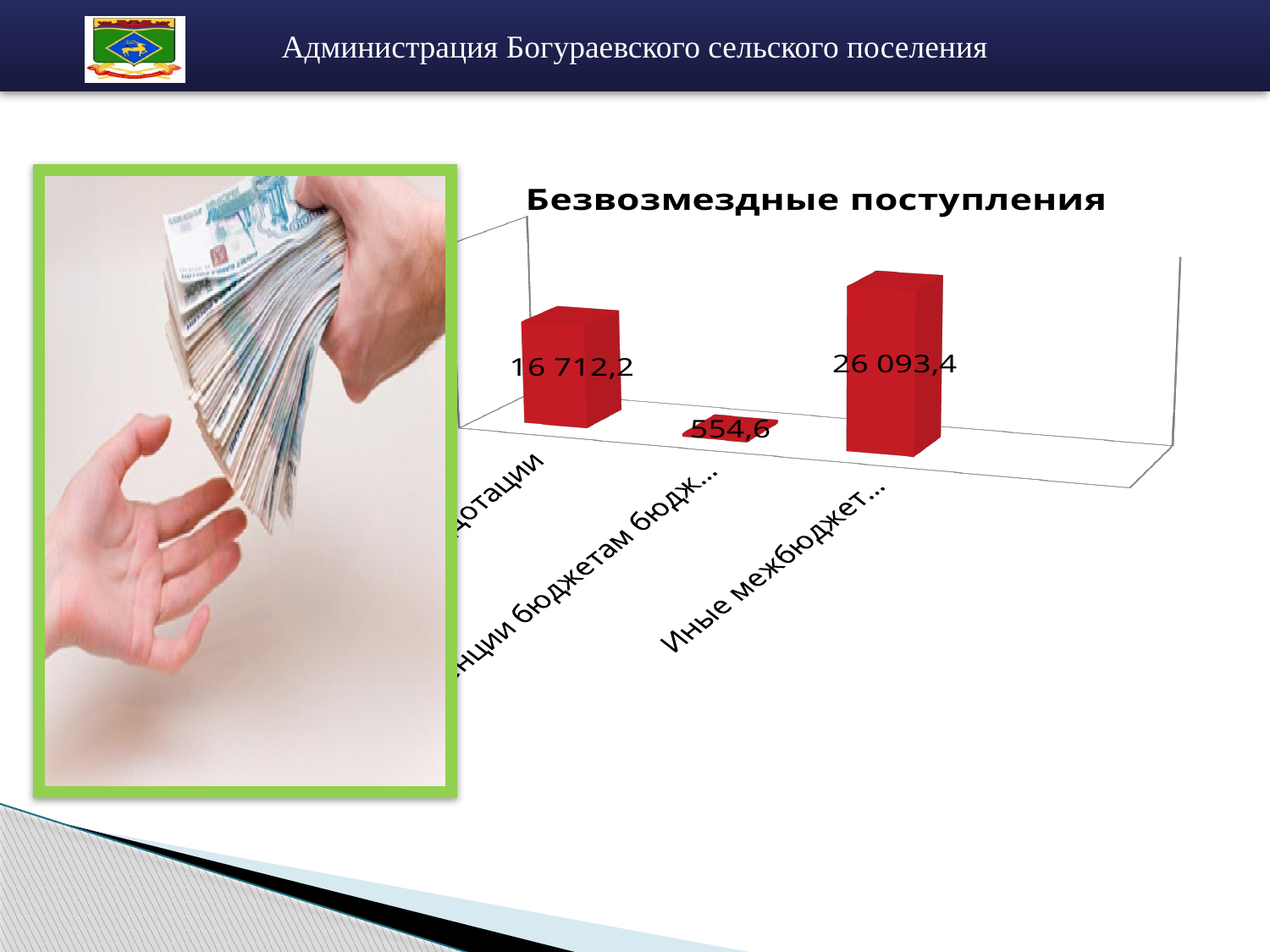
What is the difference between the leftmost bar (16 712,2) and the middle bar (554,6)? 16 157,6 What is the title of the chart? Безвозмездные поступления What colour are the bars in the chart? red What value is labelled on the middle bar of the chart? 554,6 What kind of chart is shown on the slide? bar chart What value is labelled on the bar for 'Иные межбюджет…' (the rightmost bar)? 26 093,4 What value is labelled on the first (leftmost) bar of the chart? 16 712,2 Which is larger: the value of the leftmost bar or the value of the middle bar? the leftmost bar (16 712,2) Which bar has the lowest value? the middle bar (554,6) What is the difference between the rightmost bar (26 093,4) and the leftmost bar (16 712,2)? 9 381,2 How many bars (categories) does the chart show? 3 Which bar has the highest value? the rightmost bar, Иные межбюджет… (26 093,4)